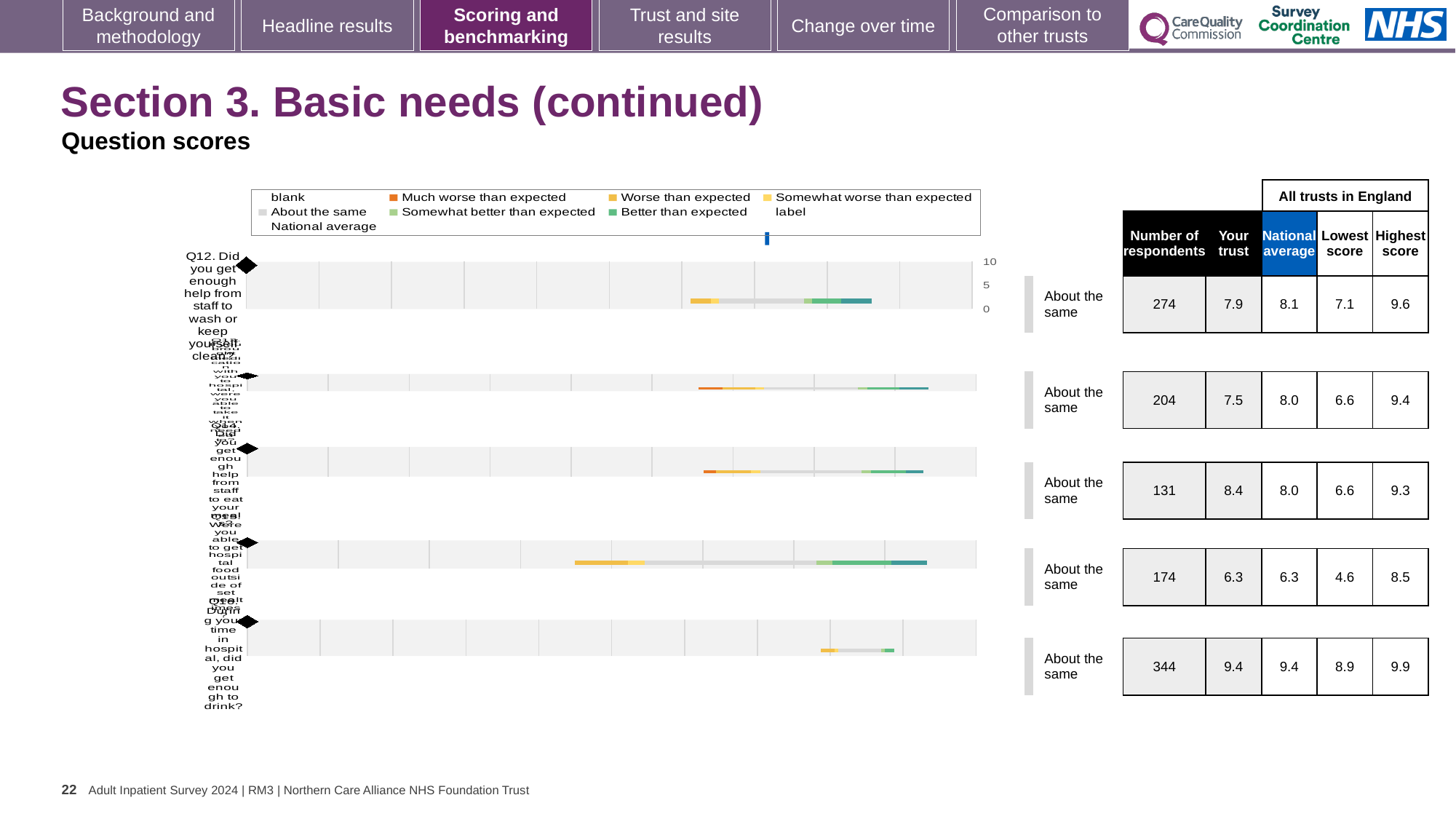
How many questions (rows) are plotted in the chart? 5 In the table next to the chart, what is the national average for Q12 (help from staff to wash or keep yourself clean)? 8.1 In the table next to the chart, what is the highest score for the last row (Q16, enough to drink)? 9.9 In the table next to the chart, what is the lowest score for the fourth row? 4.6 What benchmark category is shown for every question row on this slide? About the same For Q12, which is larger: the 'Your trust' score or the national average? national average What kind of chart is used to show the question scores on this slide? bar chart For Q12, what is the difference between the national average and the 'Your trust' score? 0.2 In the table next to the chart, what is the 'Your trust' score for Q12 (help from staff to wash or keep yourself clean)? 7.9 Which row has the lowest 'Your trust' score in the table next to the chart? the fourth row, 6.3 Which row has the highest 'Your trust' score in the table next to the chart? the last row (Q16, enough to drink), 9.4 In the table next to the chart, how many respondents are listed for the first row (Q12)? 274